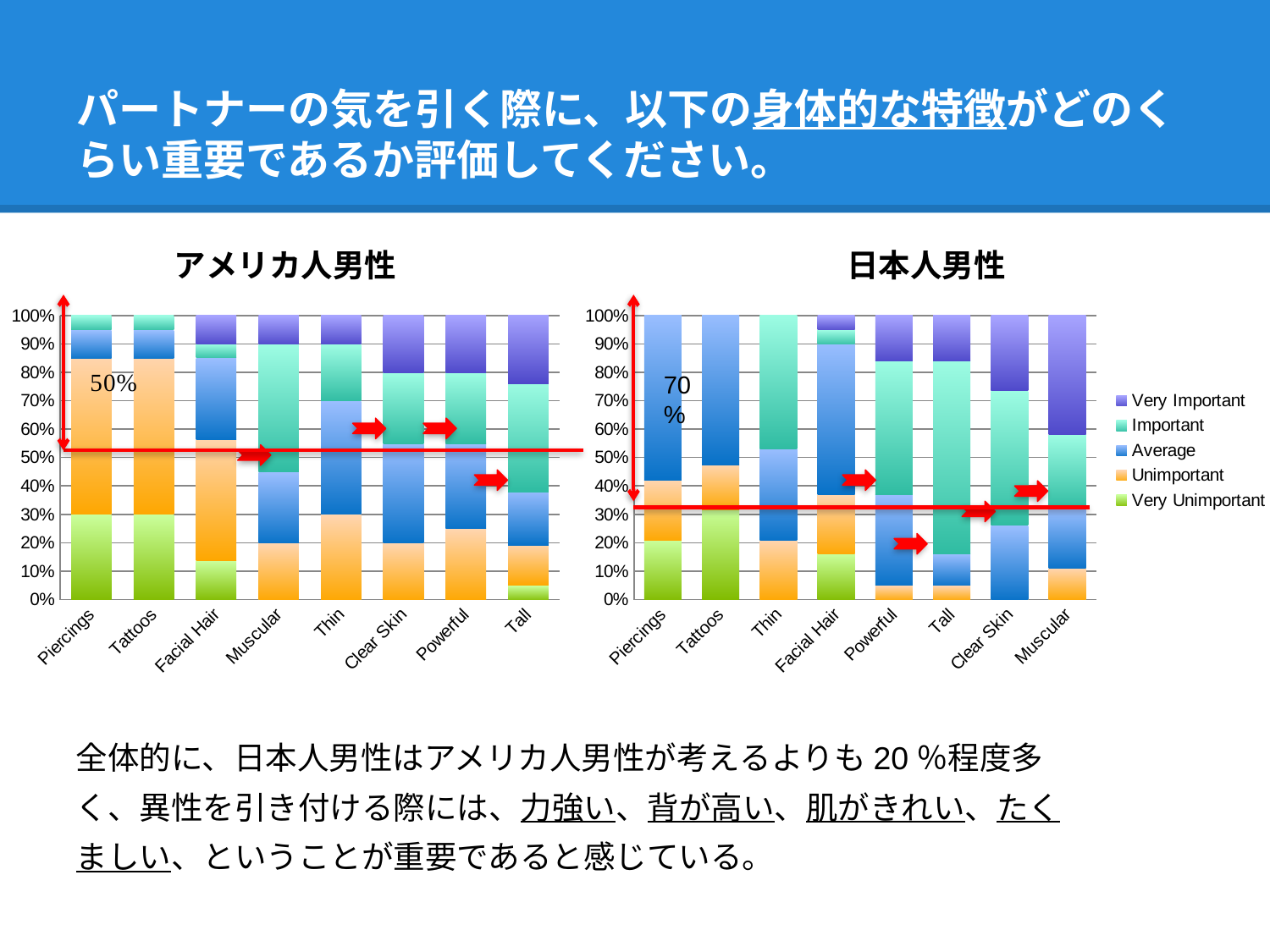
In the アメリカ人男性 chart, which category has the largest Very Important segment? Tall In the アメリカ人男性 chart, is the Very Unimportant segment for Tall greater or less than 10%? less Which series is listed first in the legend? Very Important What is the title of the chart on the left? アメリカ人男性 How many series does the legend list for the charts? 5 In the アメリカ人男性 chart, is the Unimportant segment for Tattoos greater or less than 40%? greater What kind of chart is the アメリカ人男性 chart on the left? Stacked bar chart How many categories are shown on the x axis of the 日本人男性 chart on the right? 8 In the 日本人男性 chart, which category has the largest Very Important segment? Muscular In the 日本人男性 chart, which category has the larger Very Unimportant segment, Tattoos or Powerful? Tattoos In the 日本人男性 chart, is the Average segment for Piercings greater or less than 50%? greater